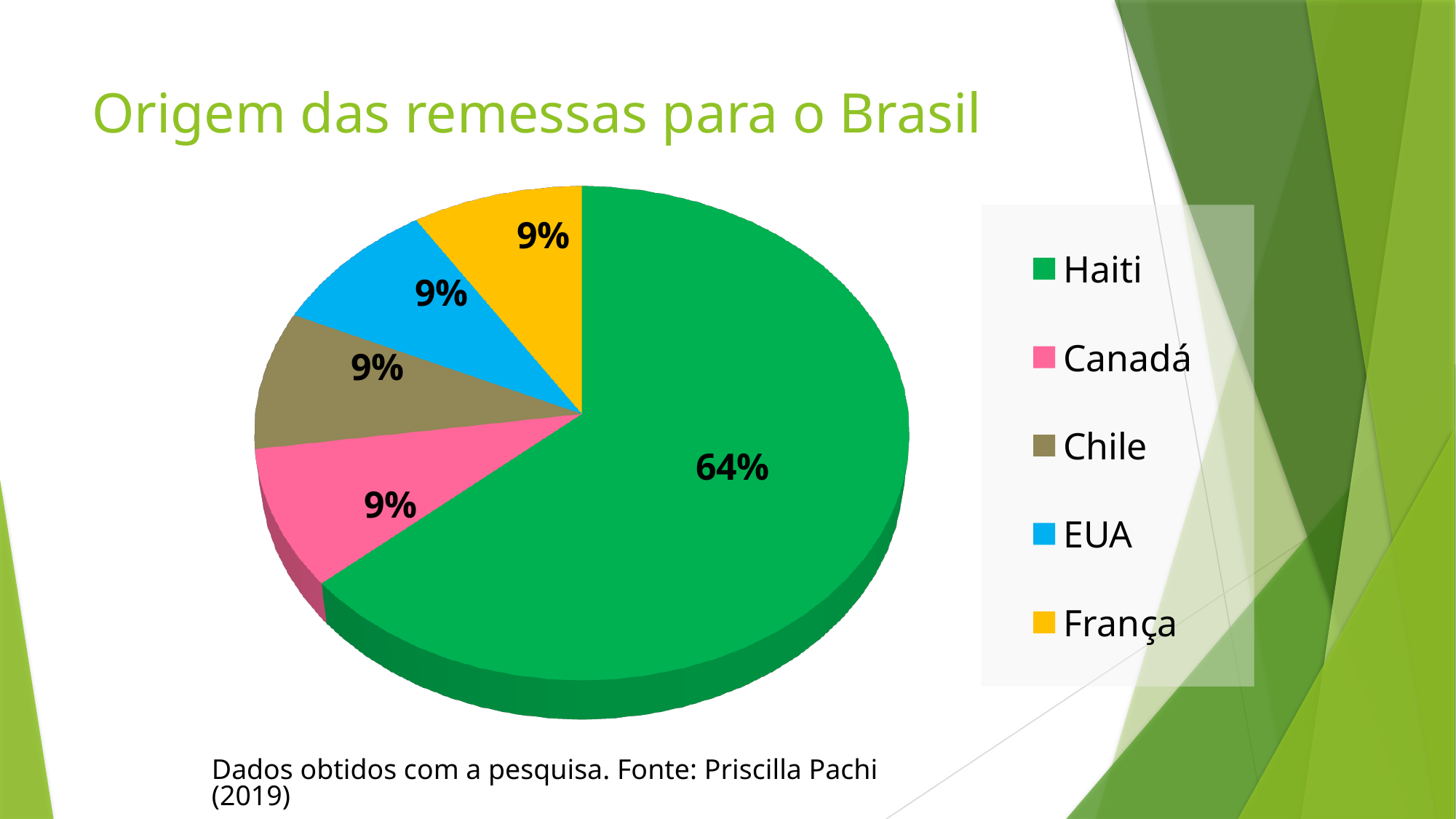
How many categories are shown in the pie chart? 5 What kind of chart is shown on the slide? Pie chart Which category has the largest slice of the pie? Haiti What share of the pie does Haiti account for? 64% What is the value shown for Chile? 9% Which is larger, the slice for Haiti or the slice for EUA? Haiti What is the value shown for Canadá? 9% Which category is shown in yellow in the legend? França What is the difference in percentage points between Haiti and Canadá? 55 What is the value shown for EUA? 9% What is the title of the slide? Origem das remessas para o Brasil What is the value shown for França? 9%